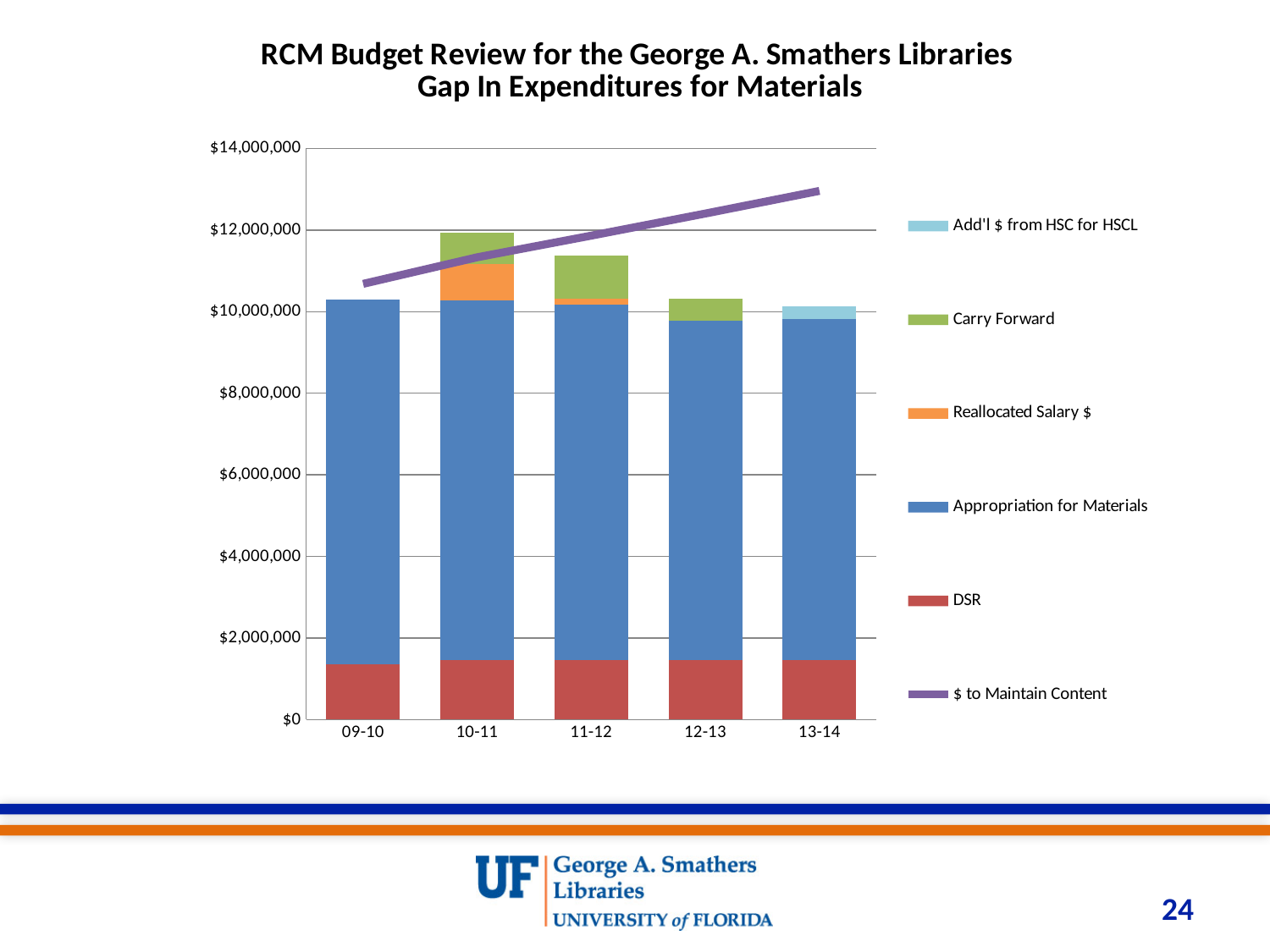
Which fiscal year has the tallest stacked bar? 10-11 Does the "$ to Maintain Content" line rise or fall from 09-10 to 13-14? rise What colour represents Carry Forward in the legend? Green Is the total stacked bar for 12-13 greater or less than $12,000,000? less How many fiscal years are shown on the x axis? 5 Which series is shown as a line rather than a bar segment? $ to Maintain Content How many series does the legend list? 6 Is the total stacked bar for 09-10 greater or less than $10,000,000? greater Is the DSR value for 11-12 greater or less than $2,000,000? less What kind of chart is shown on the slide? Stacked bar chart with a line